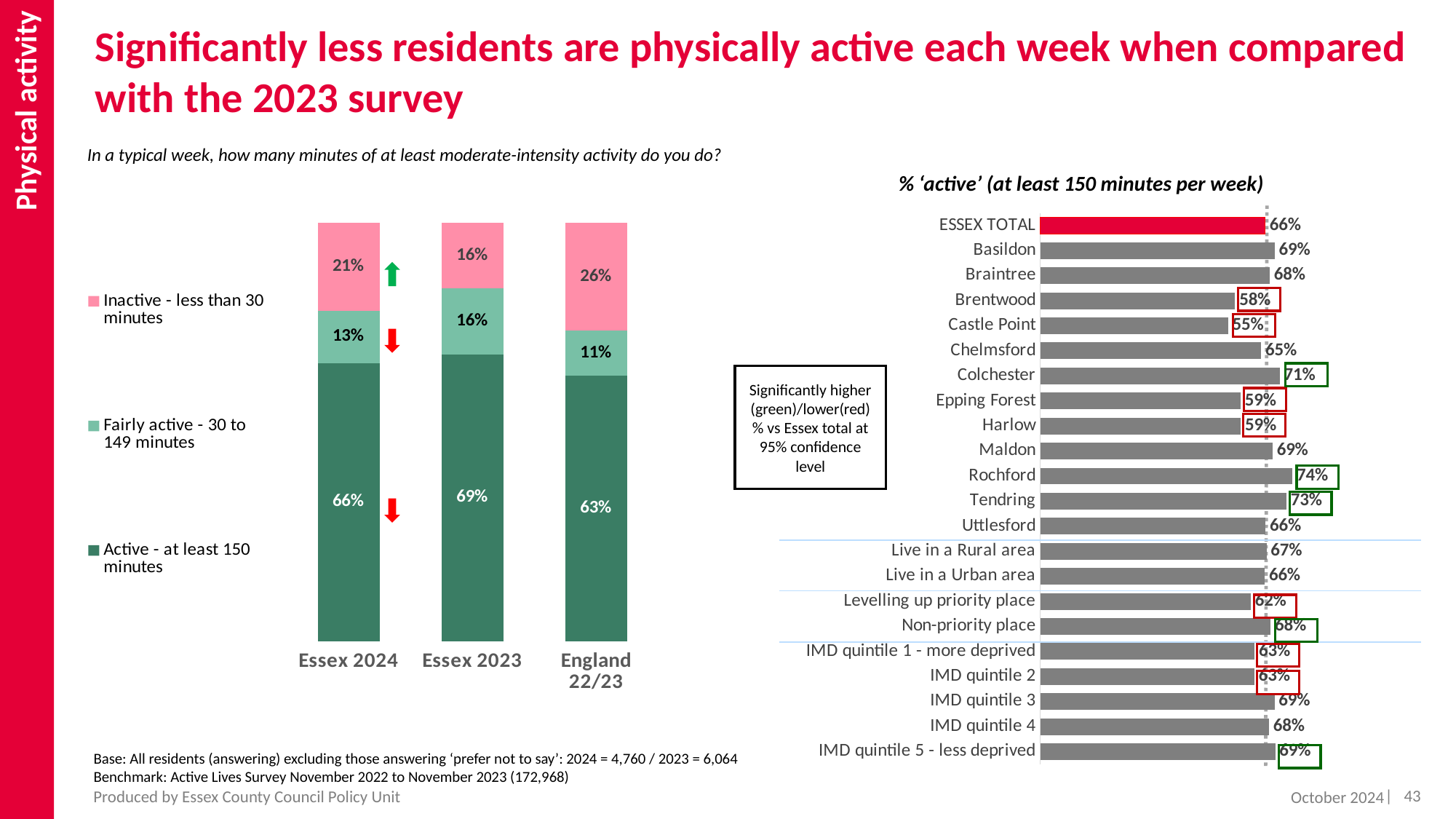
In the '% active (at least 150 minutes per week)' chart, what is the value for Castle Point? 55% In the stacked bar chart on the left, what is the 'Fairly active - 30 to 149 minutes' value for England 22/23? 11% In the stacked bar chart on the left, what percentage of Essex 2023 residents are 'Inactive - less than 30 minutes'? 16% In the '% active (at least 150 minutes per week)' chart, which district has the highest value? Rochford In the stacked bar chart on the left, which bar has the highest 'Inactive - less than 30 minutes' share? England 22/23 What kind of chart is the '% active (at least 150 minutes per week)' chart? Bar chart In the '% active (at least 150 minutes per week)' chart, what is the difference between Tendring and ESSEX TOTAL? 7% In the '% active (at least 150 minutes per week)' chart, which category has the lowest value? Castle Point In the stacked bar chart on the left, how many series does the legend list? 3 In the '% active (at least 150 minutes per week)' chart, which is larger: 'Live in a Rural area' or 'Levelling up priority place'? Live in a Rural area In the stacked bar chart on the left, what is the difference between the 'Active' share for Essex 2023 and Essex 2024? 3% In the stacked bar chart on the left, what percentage of Essex 2024 residents are 'Active - at least 150 minutes'? 66%